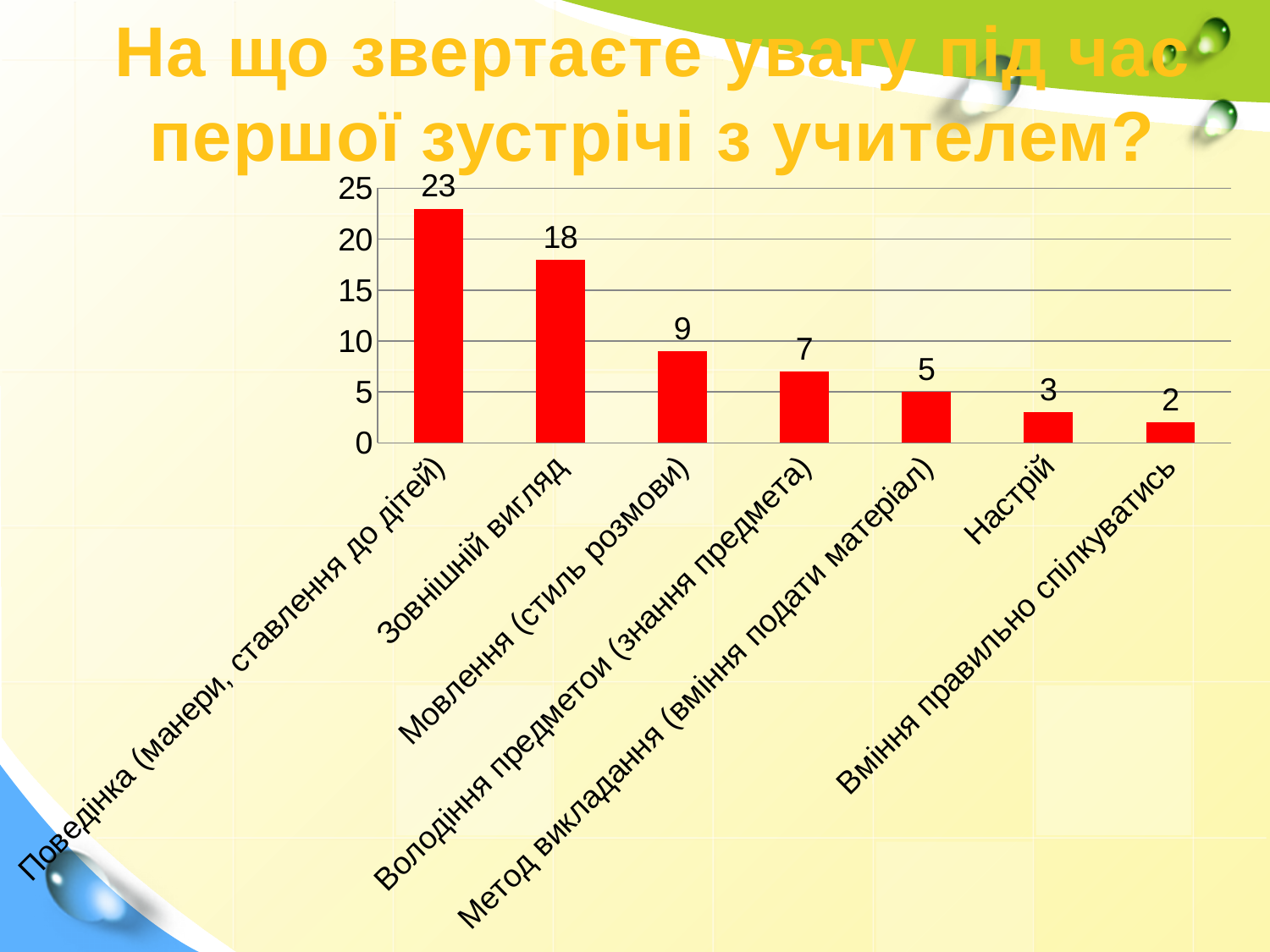
What is the value for Настрій? 3 Which category has the lowest value? Вміння правильно спілкуватись How many categories are shown in the chart? 7 Which category has the highest value? Поведінка (манери, ставлення до дітей) Which is larger: the value for Володіння предметом (знання предмета) or the value for Метод викладання (вміння подати матеріал)? Володіння предметом (знання предмета) Is the value for Зовнішній вигляд greater or less than 15? greater What is the difference between the values for Поведінка (манери, ставлення до дітей) and Зовнішній вигляд? 5 What is the value for Мовлення (стиль розмови)? 9 What colour are the bars in the chart? red Do the values rise or fall from left to right along the x axis? fall What is the value for Зовнішній вигляд? 18 What kind of chart is shown on the slide? bar chart